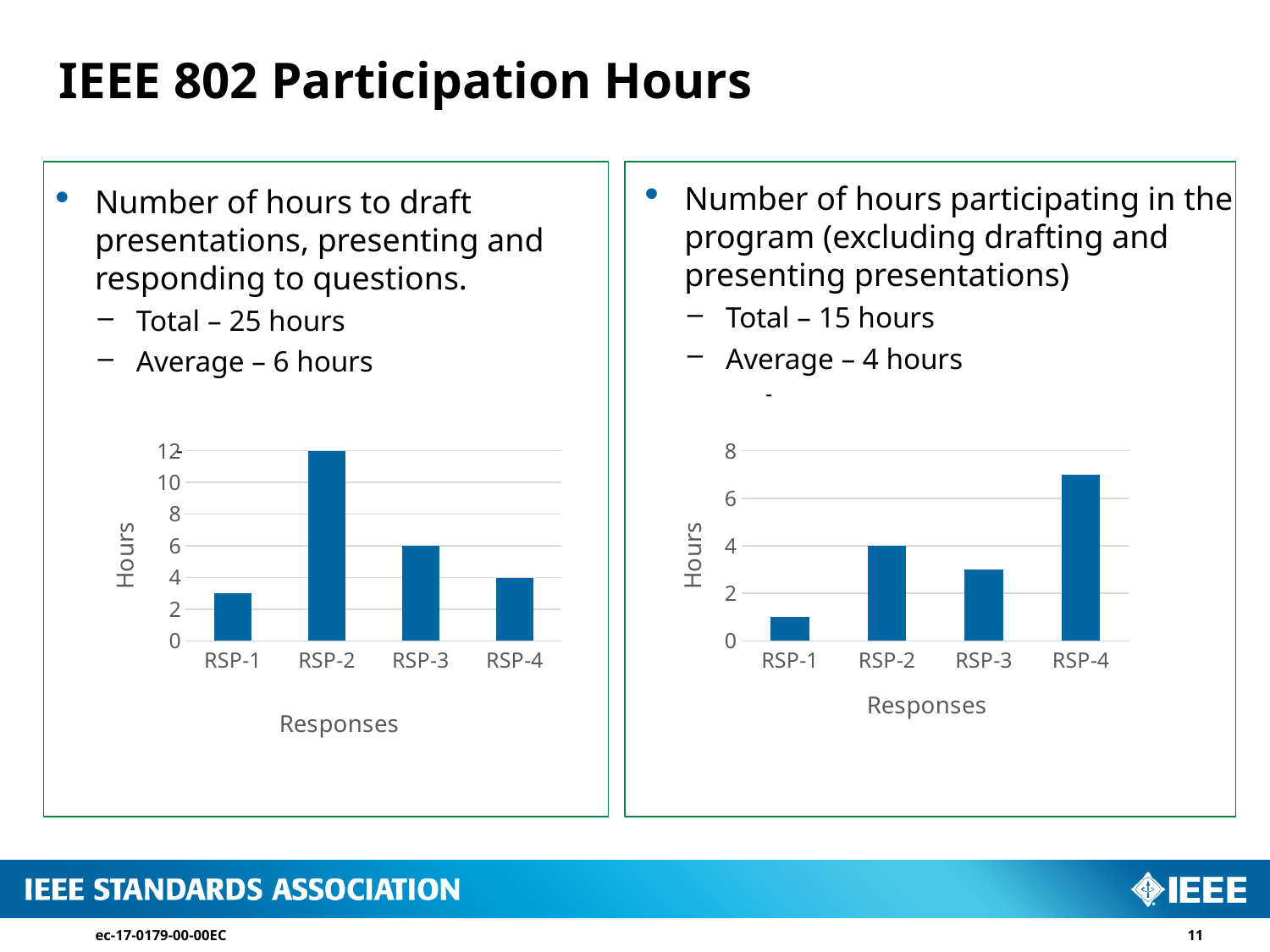
In the right chart, is the value for RSP-4 greater or less than 6? greater In the right chart, which response has the lowest number of hours? RSP-1 In the left chart, what is the value for RSP-3? 6 In the left chart, which response has the highest number of hours? RSP-2 In the right chart, which response has the highest number of hours? RSP-4 In the left chart, is the value for RSP-1 greater or less than 4? less In the left chart, what is the value for RSP-2? 12 How many categories are shown on the x axis of the left chart? 4 In the right chart, what is the value for RSP-2? 4 In the right chart, which is larger, the value for RSP-2 or the value for RSP-3? RSP-2 In the left chart, which response has the lowest number of hours? RSP-1 In the left chart, what is the difference between the values for RSP-2 and RSP-4? 8